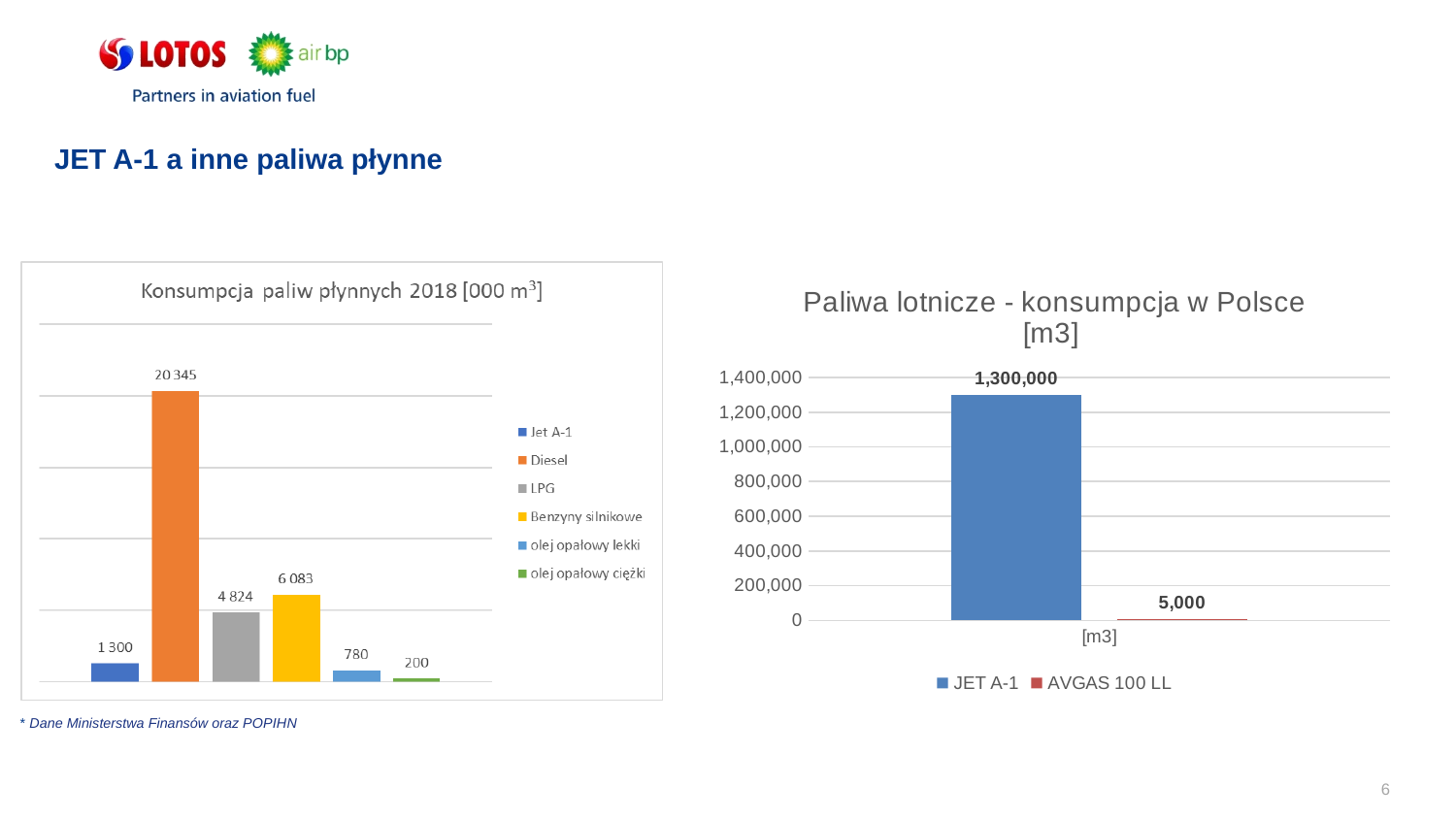
In the chart titled 'Konsumpcja paliw płynnych 2018 [000 m³]', which fuel has the lowest value? olej opałowy ciężki In the chart titled 'Konsumpcja paliw płynnych 2018 [000 m³]', which is larger, the value for Jet A-1 or the value for olej opałowy lekki? Jet A-1 How many series does the legend of the chart titled 'Konsumpcja paliw płynnych 2018 [000 m³]' list? 6 How many series does the legend of the chart titled 'Paliwa lotnicze - konsumpcja w Polsce [m3]' list? 2 What kind of chart is the chart titled 'Paliwa lotnicze - konsumpcja w Polsce [m3]'? Bar chart In the chart titled 'Paliwa lotnicze - konsumpcja w Polsce [m3]', what is the value for JET A-1? 1,300,000 In the chart titled 'Konsumpcja paliw płynnych 2018 [000 m³]', what is the value for Benzyny silnikowe? 6 083 In the chart titled 'Konsumpcja paliw płynnych 2018 [000 m³]', what is the difference between the values for Benzyny silnikowe and LPG? 1 259 In the chart titled 'Konsumpcja paliw płynnych 2018 [000 m³]', which fuel has the highest value? Diesel In the chart titled 'Paliwa lotnicze - konsumpcja w Polsce [m3]', what is the difference between the values for JET A-1 and AVGAS 100 LL? 1,295,000 In the chart titled 'Konsumpcja paliw płynnych 2018 [000 m³]', what is the value for Diesel? 20 345 In the chart titled 'Paliwa lotnicze - konsumpcja w Polsce [m3]', what is the value for AVGAS 100 LL? 5,000